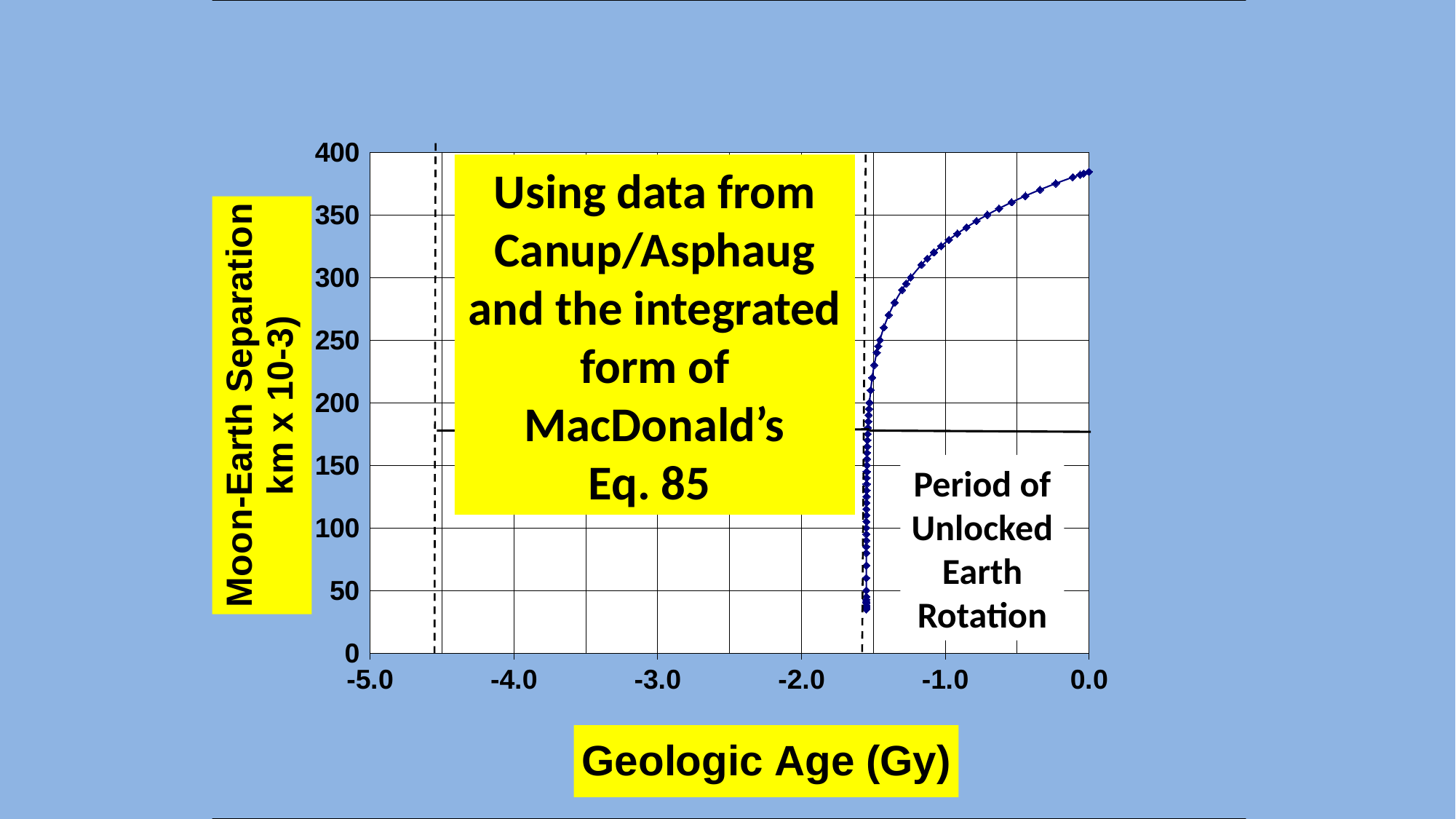
What kind of chart is shown on the slide? line chart Do the plotted values rise or fall as Geologic Age moves from -1.5 toward 0.0 along the x axis? rise Is the Moon-Earth Separation value at Geologic Age -1.0 greater or less than 300? greater Is the lowest plotted Moon-Earth Separation value greater or less than 50? less What is the label of the y axis? Moon-Earth Separation km x 10-3 At which end of the x axis does the curve reach its highest Moon-Earth Separation value? 0.0 Is the Moon-Earth Separation value at Geologic Age 0.0 greater or less than 350? greater What is the label of the x axis? Geologic Age (Gy)